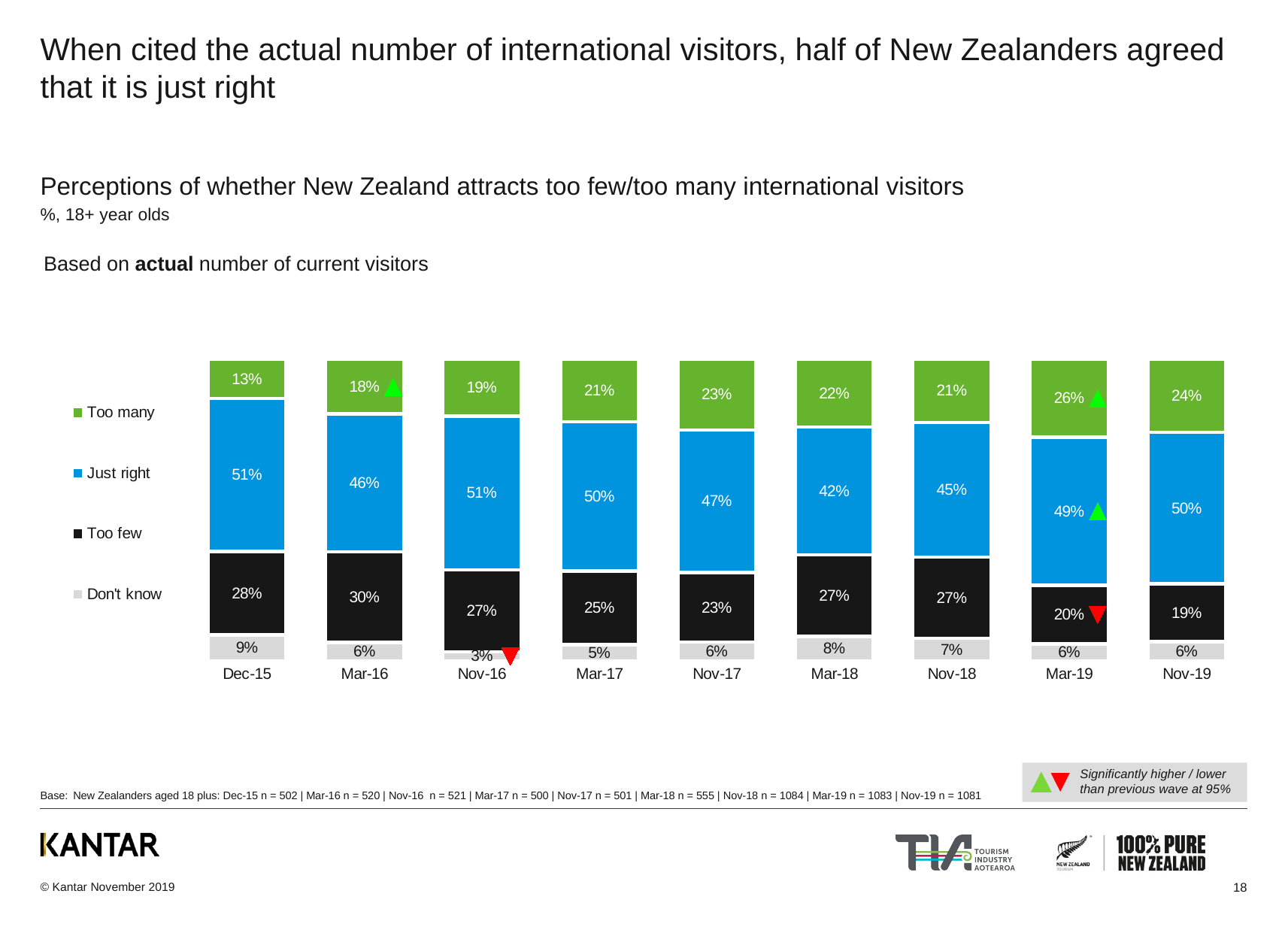
By how many percentage points did the 'Too many' share in Nov-19 exceed that in Dec-15? 11 percentage points In which wave was the 'Don't know' share lowest? Nov-16 What percentage said 'Don't know' in Mar-18? 8% What kind of chart is shown? Stacked bar chart In which wave was the 'Too few' share lowest? Nov-19 Which wave had a higher 'Just right' share, Mar-18 or Nov-18? Nov-18 In which wave was the 'Too many' share highest? Mar-19 What percentage said 'Too few' in Mar-16? 30% How many series does the legend list? 4 What percentage said 'Just right' in Nov-19? 50% How many survey waves are shown on the x axis? 9 Does the 'Too many' share generally rise or fall from Dec-15 to Nov-19? Rise